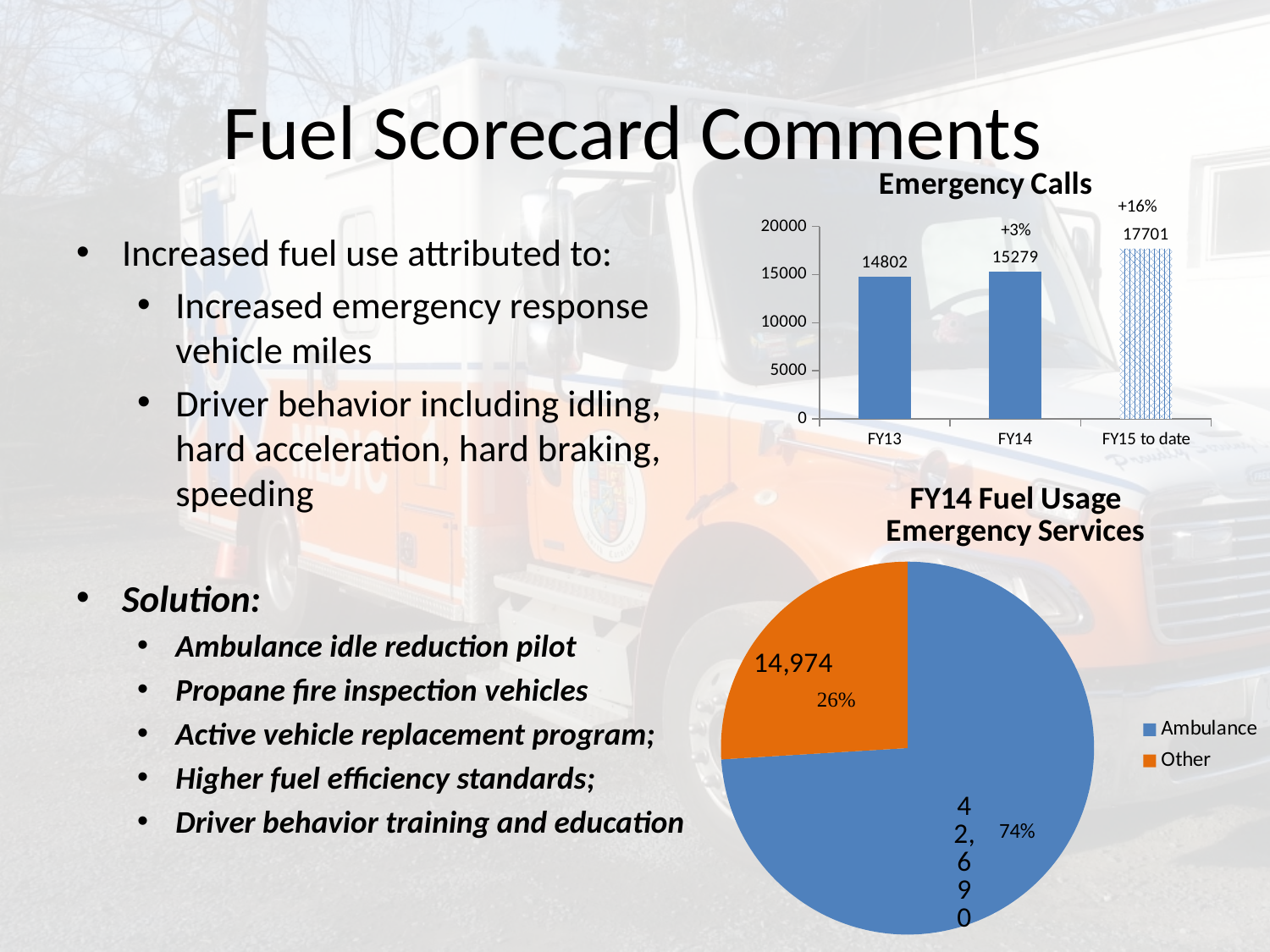
In the Emergency Calls chart, what is the difference between the FY14 and FY13 values? 477 In the Emergency Calls chart, do the values rise or fall from FY13 to FY15 to date? rise In the FY14 Fuel Usage Emergency Services chart, what share of the pie is Other? 26% In the Emergency Calls chart, what is the value for FY15 to date? 17701 What kind of chart is the Emergency Calls chart? bar chart How many series does the legend of the FY14 Fuel Usage Emergency Services chart list? 2 In the Emergency Calls chart, which category has the highest value? FY15 to date In the Emergency Calls chart, what is the value for FY14? 15279 In the Emergency Calls chart, what is the value for FY13? 14802 In the Emergency Calls chart, which category has the lowest value? FY13 In the FY14 Fuel Usage Emergency Services chart, what is the value for Other? 14,974 In the Emergency Calls chart, how many categories are shown on the x axis? 3